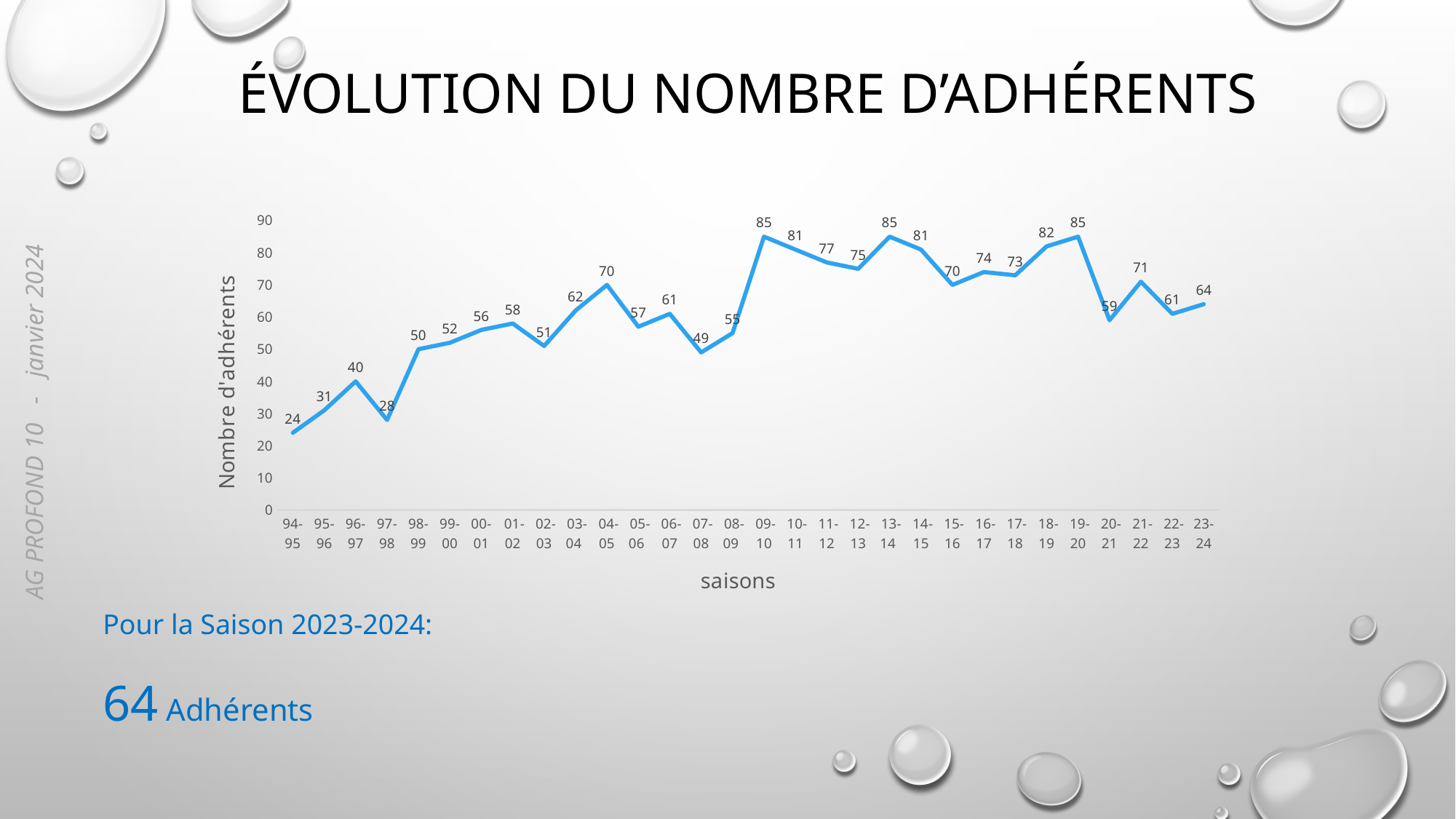
What is the number of adhérents for the 09-10 season? 85 What is the difference in adhérents between the 23-24 season and the 22-23 season? 3 What is the difference in adhérents between the 19-20 season and the 20-21 season? 26 Between the 94-95 and 96-97 seasons, does the number of adhérents rise or fall? Rise What is the number of adhérents for the 23-24 season? 64 What is the label of the vertical axis? Nombre d'adhérents What is the number of adhérents for the 94-95 season? 24 What kind of chart is shown on the slide? Line chart Which season has the lowest number of adhérents? 94-95 How many seasons are plotted on the chart? 30 What is the highest number of adhérents shown on the chart? 85 Which season has more adhérents, 04-05 or 05-06? 04-05